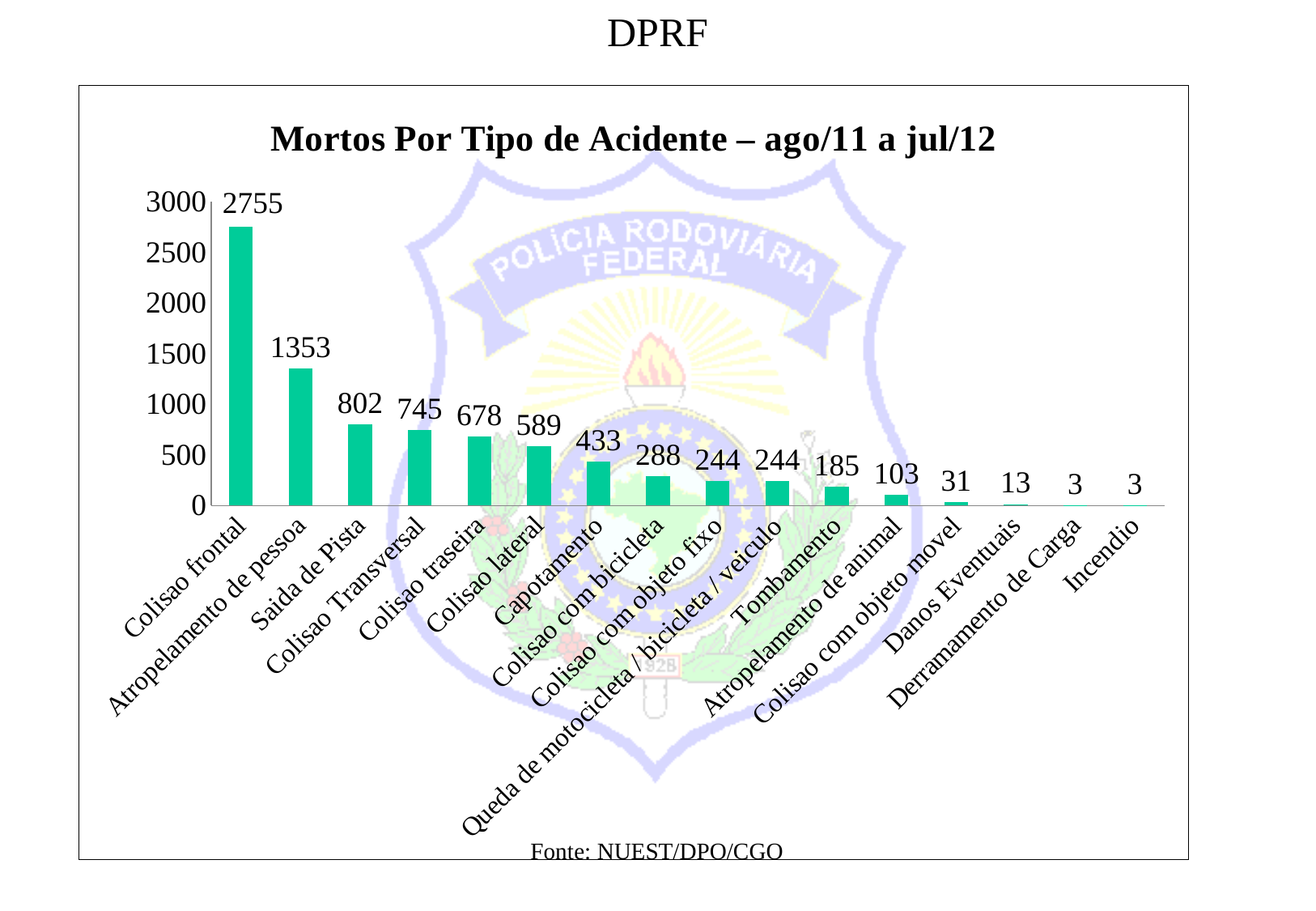
How many accident types (categories) are shown in the chart? 16 What is the difference between the values for Saida de Pista and Colisao Transversal? 57 What is the difference between the values for Colisao frontal and Atropelamento de pessoa? 1402 Which has a larger value, Colisao traseira or Colisao lateral? Colisao traseira What is the title of the chart? Mortos Por Tipo de Acidente – ago/11 a jul/12 What is the value for Tombamento? 185 How many deaths are shown for Colisao frontal? 2755 Which accident type has the highest number of deaths? Colisao frontal What type of chart is shown on the slide? bar chart What source is cited below the chart? Fonte: NUEST/DPO/CGO How many deaths are shown for Atropelamento de pessoa? 1353 What is the value for Capotamento? 433